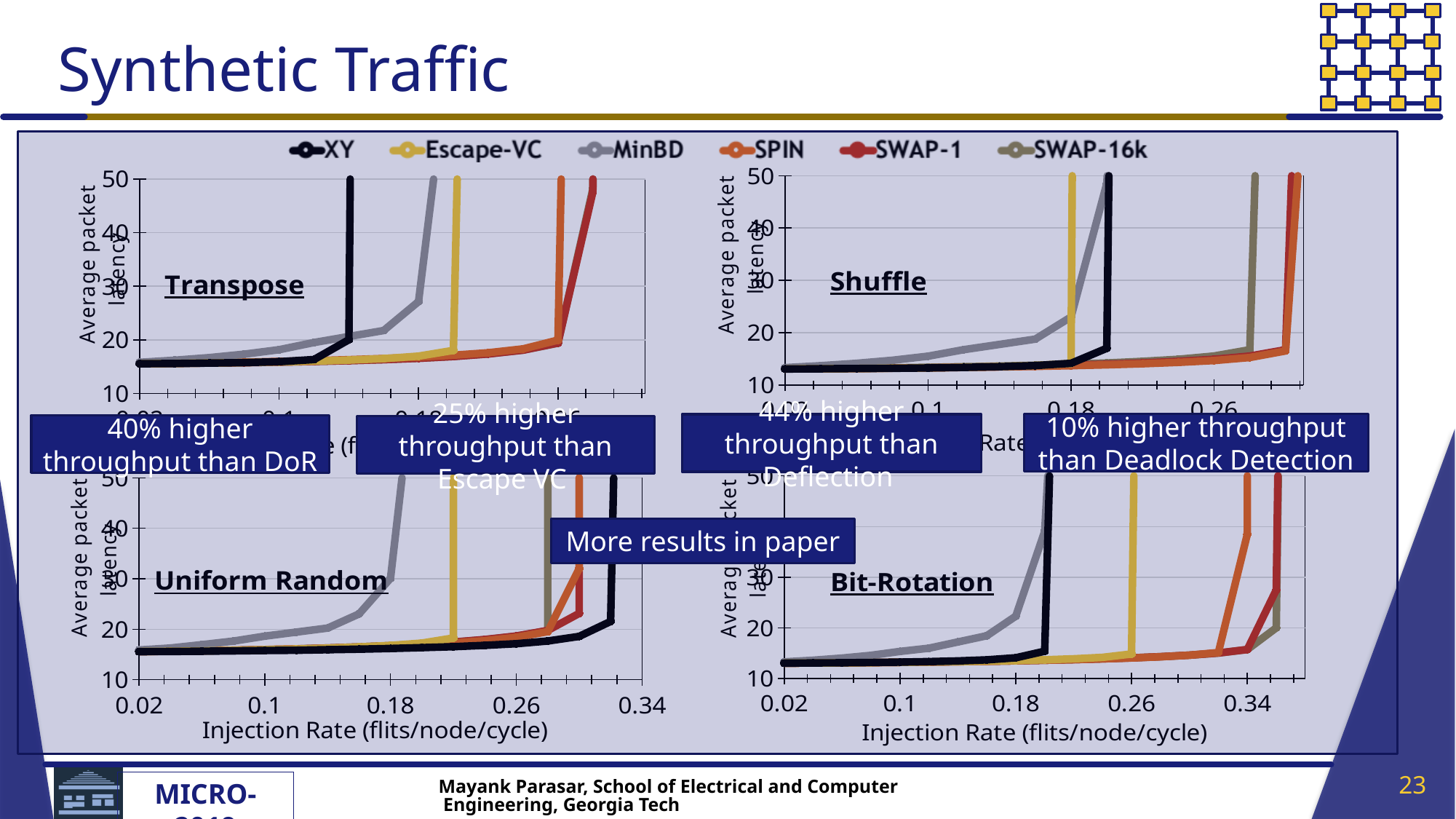
In the Uniform Random chart, is the injection rate at which the XY series spikes to 50 greater or less than 0.26? greater In the Uniform Random chart, which series reaches its latency spike at a higher injection rate, MinBD or XY? XY In the Bit-Rotation chart, which series reaches its latency spike at a higher injection rate, XY or Escape-VC? Escape-VC In the Shuffle chart, which series reaches its latency spike at a higher injection rate, Escape-VC or SWAP-1? SWAP-1 Which series are listed in the legend at the top of the slide? XY, Escape-VC, MinBD, SPIN, SWAP-1, SWAP-16k How many series does the legend at the top of the slide list? 6 In the Transpose chart, does average packet latency rise or fall as injection rate increases? rise What is the x-axis label of the Uniform Random chart? Injection Rate (flits/node/cycle) In the Bit-Rotation chart, is the injection rate at which the XY series spikes to 50 greater or less than 0.26? less What kind of chart is the Transpose chart? line chart How many charts are shown on the slide? 4